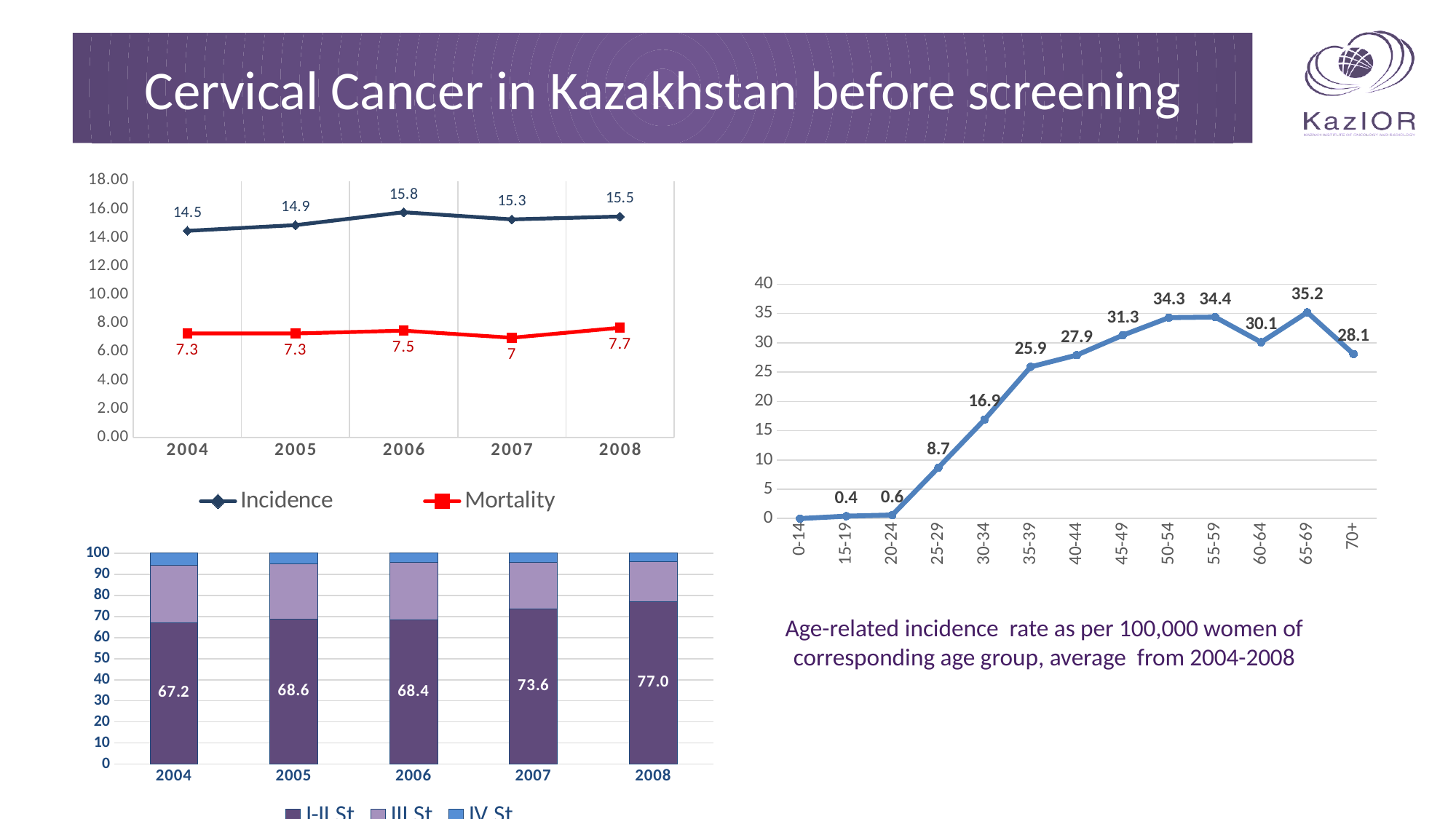
In the bottom-left stacked bar chart, is the I-II St value for 2005 larger or smaller than for 2006? larger In the bottom-left stacked bar chart, which year has the highest I-II St value? 2008 In the bottom-left stacked bar chart, what is the I-II St value for 2007? 73.6 In the right-hand age-related incidence chart, how many age groups are plotted on the x axis? 13 In the top-left line chart, what is the difference between Incidence and Mortality in 2008? 7.8 In the right-hand age-related incidence chart, which age group has the highest value? 65-69 In the right-hand age-related incidence chart, what is the value for the 35-39 age group? 25.9 In the top-left line chart, how many series does the legend list? 2 In the top-left line chart, what is the Incidence value for 2006? 15.8 In the top-left line chart, what is the Mortality value for 2007? 7 What kind of chart is the bottom-left chart? stacked bar chart In the top-left line chart, which year has the lowest Incidence value? 2004